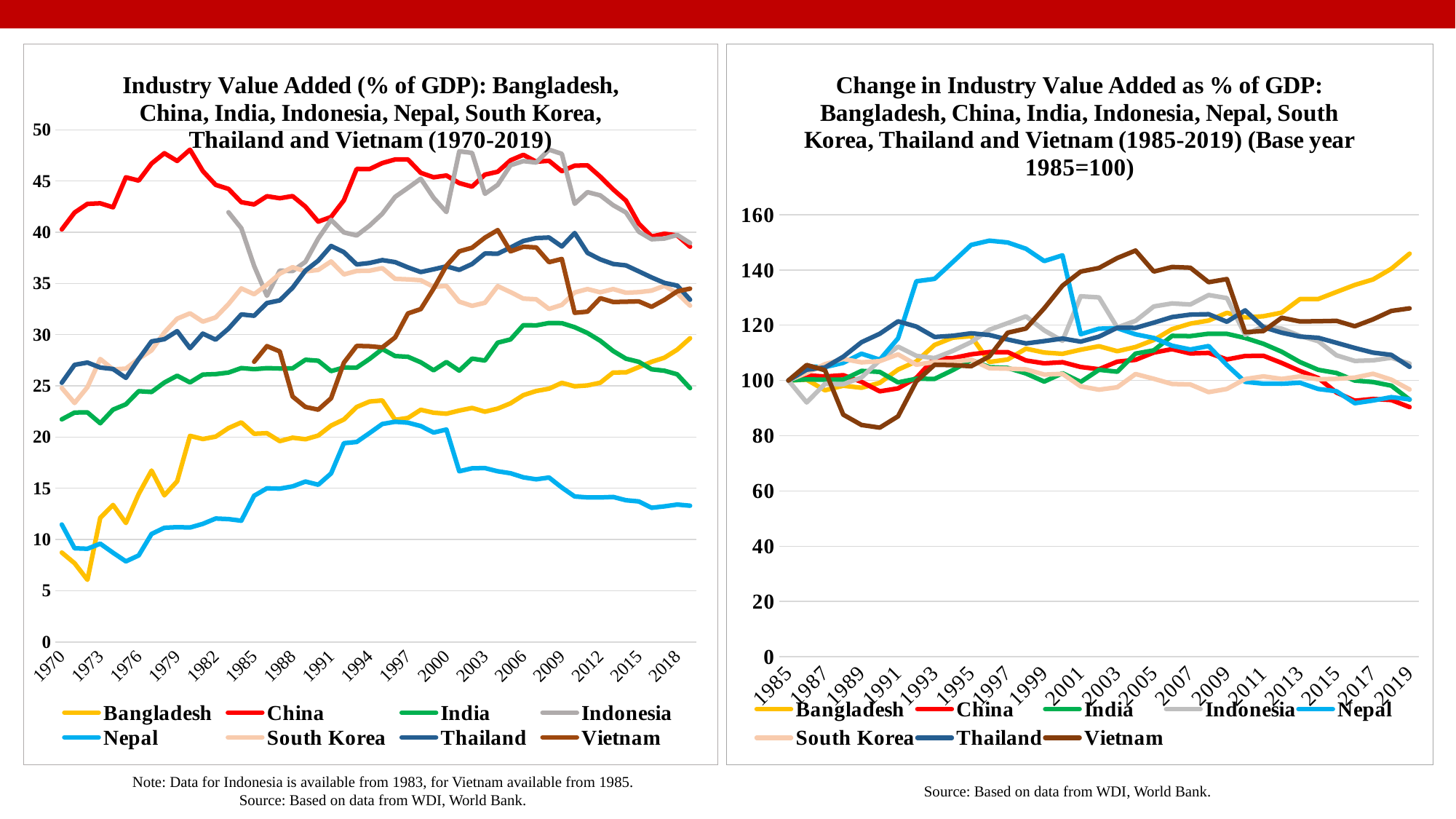
In the left chart, 'Industry Value Added (% of GDP)', does the value for Nepal rise or fall from 1997 to 2019? fall According to the title of the right chart, what is the base year used for the index? 1985=100 In the right chart, 'Change in Industry Value Added as % of GDP', is the value for Vietnam in 1991 greater or less than 100? less In the right chart, 'Change in Industry Value Added as % of GDP', is the value for Nepal in 1997 greater or less than 140? greater In the left chart, 'Industry Value Added (% of GDP)', is the value for China in 1979 greater or less than 45? greater In the right chart, 'Change in Industry Value Added as % of GDP', which series has the highest value in 2019? Bangladesh How many series does the legend of the right chart, 'Change in Industry Value Added as % of GDP', list? 8 In the left chart, 'Industry Value Added (% of GDP)', which is larger in 2019, the value for China or the value for Bangladesh? China What kind of chart is the left chart, 'Industry Value Added (% of GDP)'? line chart In the left chart, 'Industry Value Added (% of GDP)', which series has the lowest value in 2019? Nepal In the right chart, 'Change in Industry Value Added as % of GDP', does the value for Bangladesh rise or fall from 2011 to 2019? rise